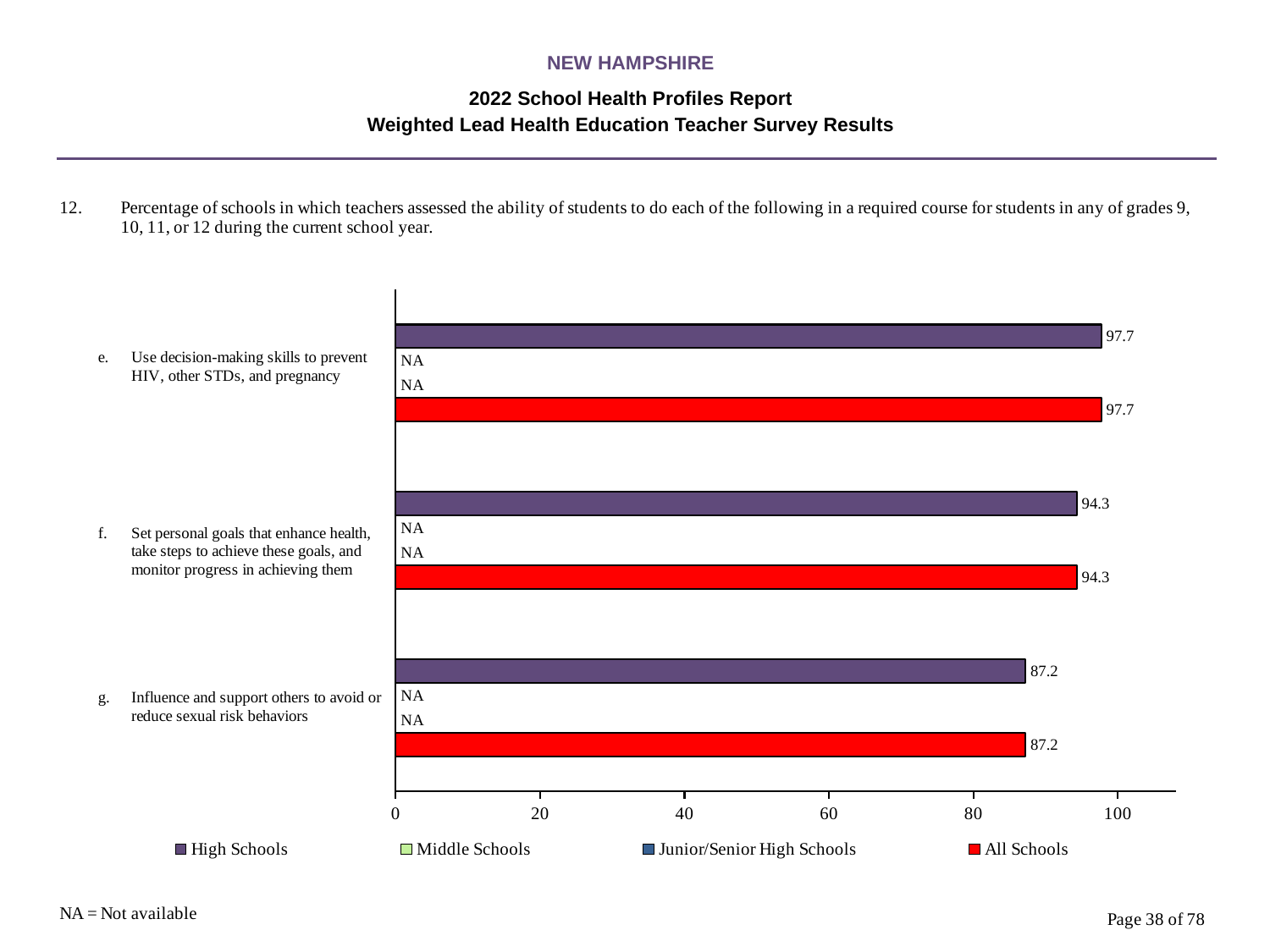
Which category has the lowest All Schools value? Influence and support others to avoid or reduce sexual risk behaviors Is the High Schools value for 'Influence and support others to avoid or reduce sexual risk behaviors' greater or less than 80? greater What value is shown for Middle Schools for 'Influence and support others to avoid or reduce sexual risk behaviors'? NA What kind of chart is shown on the slide? bar chart What is the difference between the High Schools values for 'Use decision-making skills to prevent HIV, other STDs, and pregnancy' and 'Influence and support others to avoid or reduce sexual risk behaviors'? 10.5 What is the All Schools value for 'Set personal goals that enhance health, take steps to achieve these goals, and monitor progress in achieving them'? 94.3 Which category has the highest High Schools value? Use decision-making skills to prevent HIV, other STDs, and pregnancy How many series does the legend list? 4 How many categories are shown on the chart? 3 Which is larger: the All Schools value for 'Set personal goals that enhance health...' or for 'Influence and support others to avoid or reduce sexual risk behaviors'? Set personal goals that enhance health, take steps to achieve these goals, and monitor progress in achieving them What is the High Schools value for 'Influence and support others to avoid or reduce sexual risk behaviors'? 87.2 What is the High Schools value for 'Use decision-making skills to prevent HIV, other STDs, and pregnancy'? 97.7